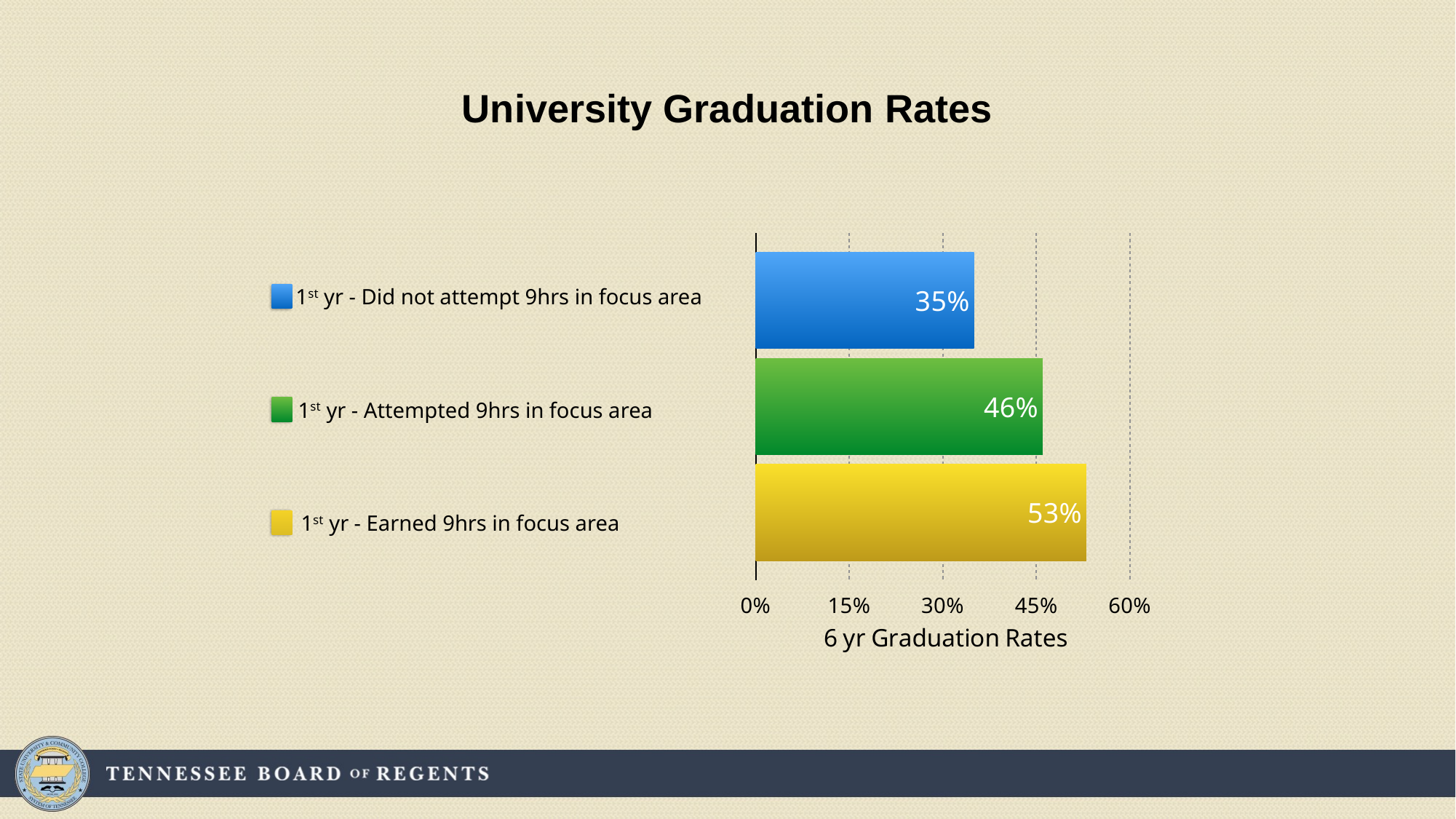
What is the 6 yr graduation rate for students who did not attempt 9hrs in the focus area in their 1st year? 35% What is the 6 yr graduation rate for students who attempted 9hrs in the focus area in their 1st year? 46% What is the 6 yr graduation rate for students who earned 9hrs in the focus area in their 1st year? 53% Which group has the lowest 6 yr graduation rate? 1st yr - Did not attempt 9hrs in focus area What is the difference in graduation rate between students who earned 9hrs and those who did not attempt 9hrs in the focus area? 18% How many groups are shown in the chart? 3 Is the graduation rate for students who earned 9hrs in the focus area greater or less than 45%? greater What is the difference in graduation rate between students who attempted 9hrs and those who did not attempt 9hrs in the focus area? 11% Which group has a higher graduation rate: those who attempted 9hrs or those who earned 9hrs in the focus area? 1st yr - Earned 9hrs in focus area Which group has the highest 6 yr graduation rate? 1st yr - Earned 9hrs in focus area What type of chart is shown on the slide? Bar chart What is the title of the chart? University Graduation Rates